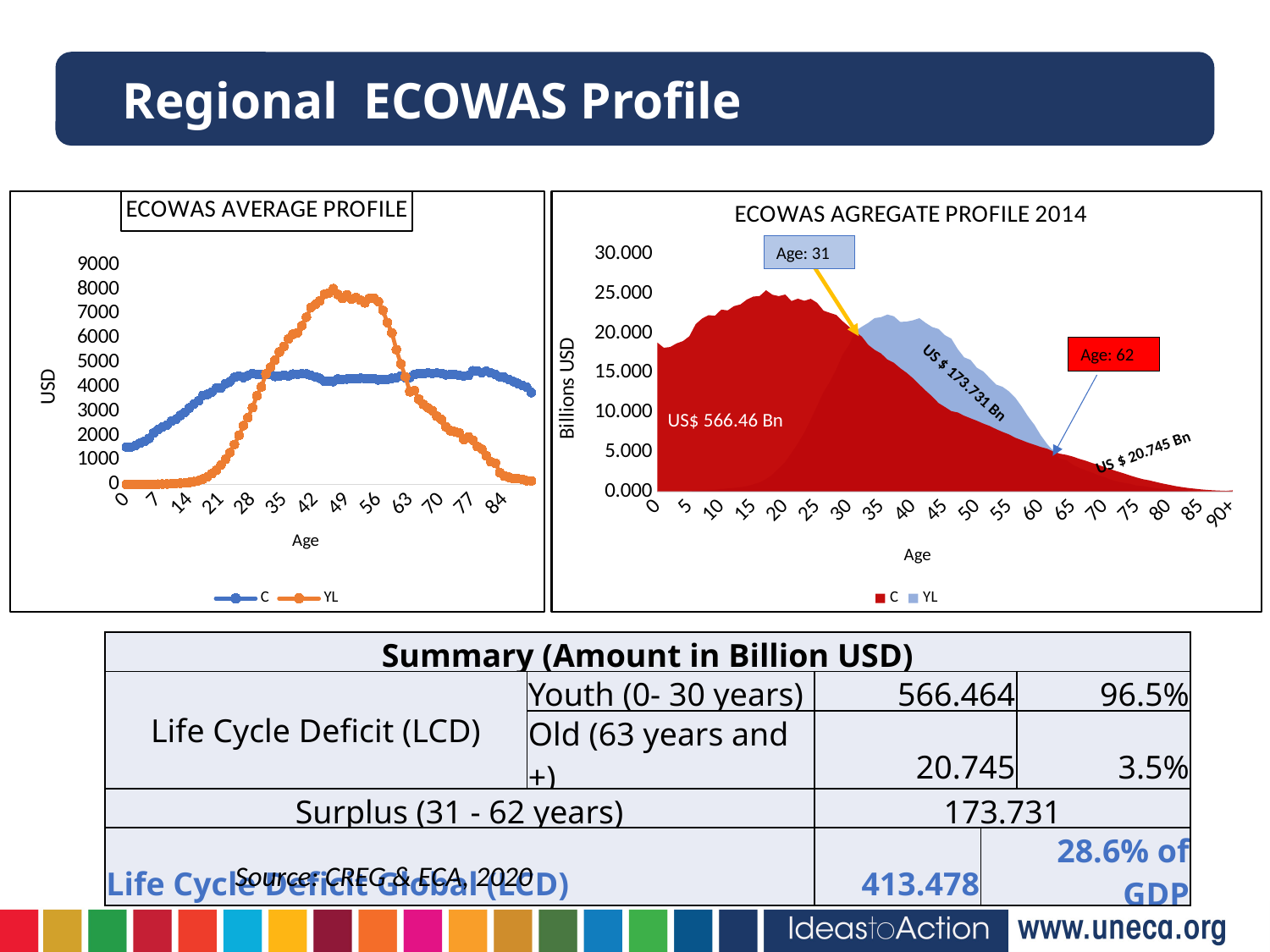
In the ECOWAS AVERAGE PROFILE chart, which series has the higher value at age 49, C or YL? YL In the ECOWAS AVERAGE PROFILE chart, is the YL value at age 49 greater or less than 7000? greater In the ECOWAS AGREGATE PROFILE 2014 chart, is the C value at age 15 greater or less than 20.000? greater In the ECOWAS AGREGATE PROFILE 2014 chart, what value is labelled on the red area for the oldest ages? US $ 20.745 Bn How many series does the legend of the ECOWAS AVERAGE PROFILE chart list? 2 In the ECOWAS AVERAGE PROFILE chart, which series has the higher value at age 7, C or YL? C What kind of chart is the ECOWAS AVERAGE PROFILE chart on the left? line chart In the ECOWAS AVERAGE PROFILE chart, is the C value at age 0 greater or less than 2000? less In the ECOWAS AGREGATE PROFILE 2014 chart, what value is labelled on the red area for the youngest ages? US$ 566.46 Bn What is the y-axis label of the ECOWAS AGREGATE PROFILE 2014 chart? Billions USD In the ECOWAS AVERAGE PROFILE chart, does the YL series rise or fall between age 49 and age 84? fall In the ECOWAS AGREGATE PROFILE 2014 chart, what value is labelled on the blue YL surplus area? US $ 173.731 Bn